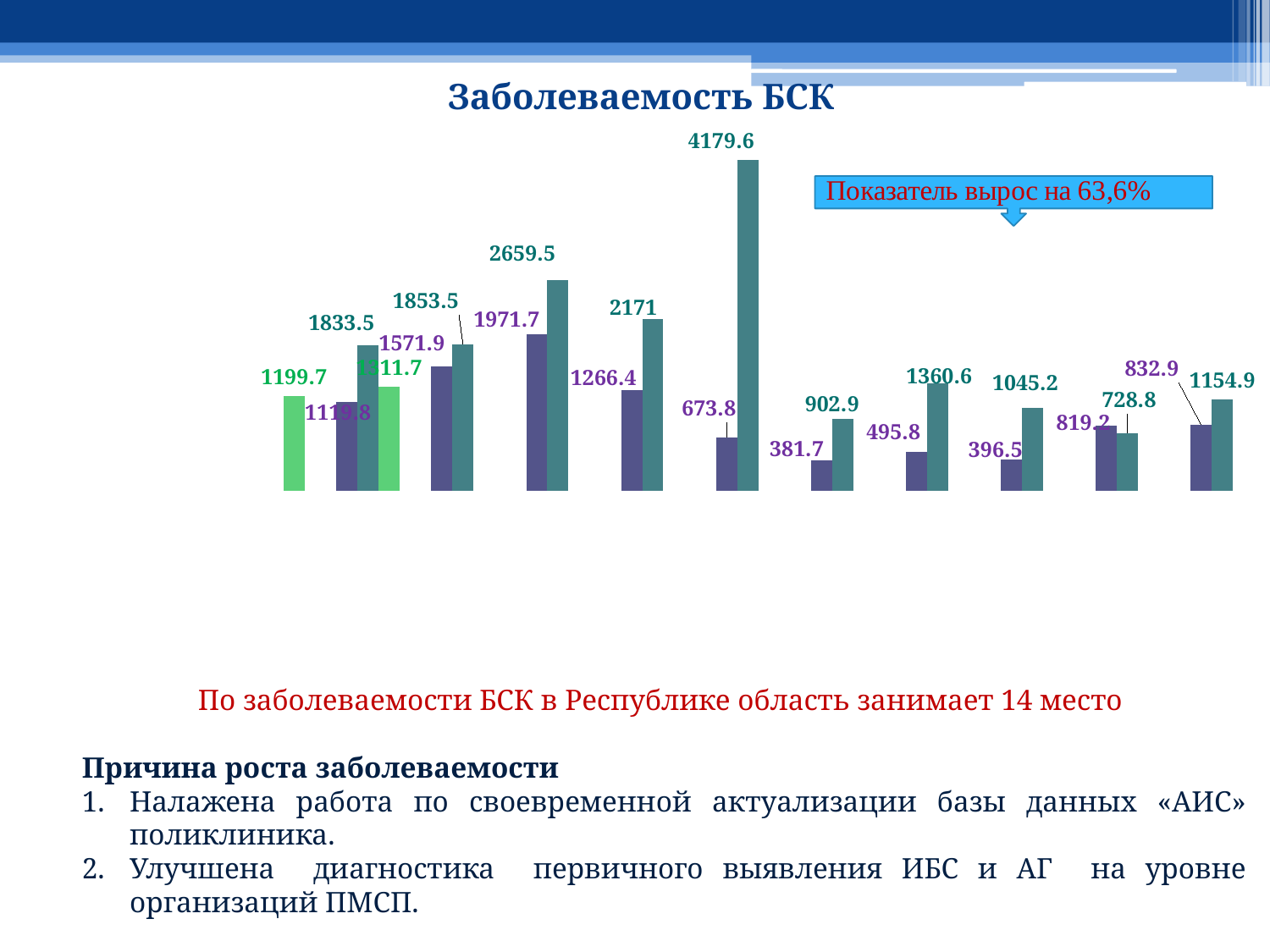
Which is larger, the bar labelled 819.2 or the bar labelled 728.8? 819.2 What is the title of the chart? Заболеваемость БСК What is the highest value labelled on the chart? 4179.6 What kind of chart is shown on the slide? bar chart What is the difference between the tallest bar (4179.6) and the shorter bar in its group (673.8)? 3505.8 What does the callout box on the chart say? Показатель вырос на 63,6% What is the lowest value labelled on the chart? 381.7 What is the second highest value labelled on the chart? 2659.5 What is the value of the shorter bar in the same group as the tallest bar (4179.6)? 673.8 How many bars on the chart have a labelled value above 2000? 3 Which is larger, the bar labelled 1360.6 or the bar labelled 1045.2? 1360.6 What is the difference between the highest labelled value (4179.6) and the lowest labelled value (381.7)? 3797.9